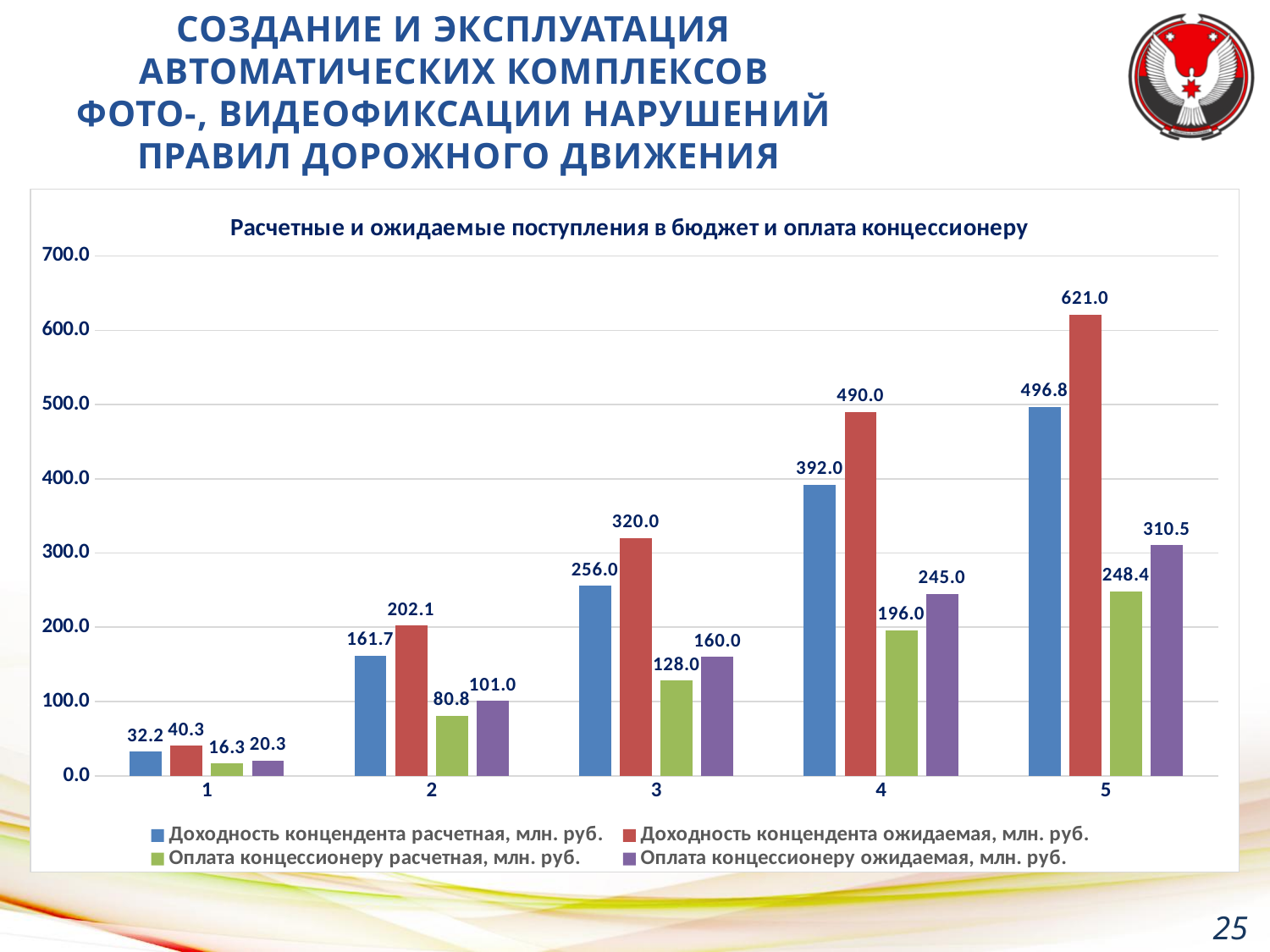
What is the difference between 'Доходность концендента ожидаемая, млн. руб.' and 'Доходность концендента расчетная, млн. руб.' for category 4? 98.0 What is the value of 'Доходность концендента расчетная, млн. руб.' for category 2? 161.7 What kind of chart is shown on the slide? Bar chart For category 5, which is larger: 'Оплата концессионеру ожидаемая, млн. руб.' or 'Оплата концессионеру расчетная, млн. руб.'? Оплата концессионеру ожидаемая, млн. руб. What is the value of 'Оплата концессионеру ожидаемая, млн. руб.' for category 4? 245.0 How many series does the legend list? 4 How many categories are shown on the x axis? 5 Which category has the highest value for 'Доходность концендента расчетная, млн. руб.'? 5 What is the value of 'Оплата концессионеру расчетная, млн. руб.' for category 3? 128.0 Which category has the lowest value for 'Оплата концессионеру ожидаемая, млн. руб.'? 1 Do the values of 'Доходность концендента ожидаемая, млн. руб.' rise or fall from category 1 to category 5? Rise What is the value of 'Доходность концендента ожидаемая, млн. руб.' for category 5? 621.0